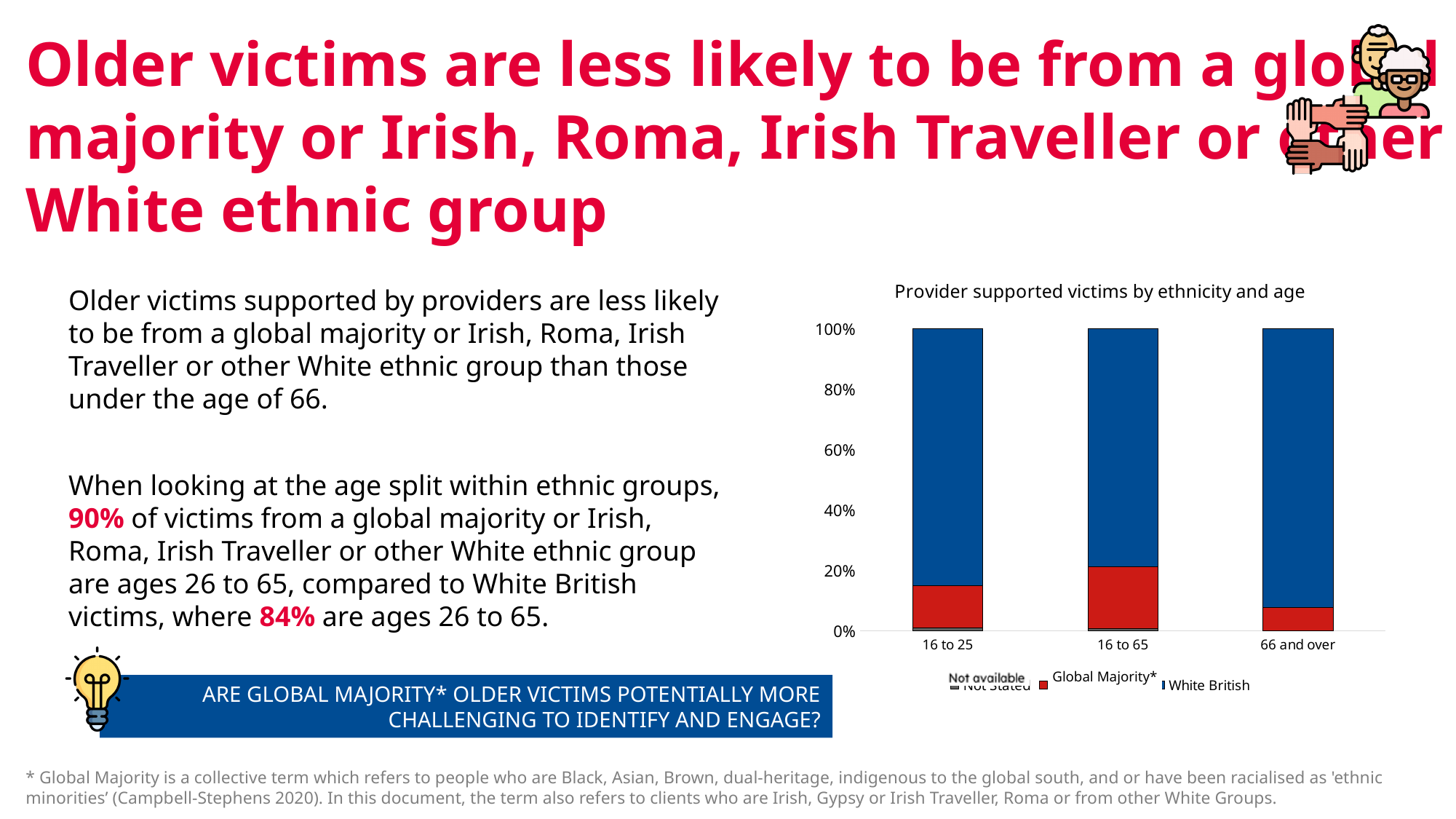
What kind of chart is shown on the slide? Stacked bar chart Which age category has the largest White British share in the chart? 66 and over Is the Global Majority* share for 66 and over greater or less than 20%? less What colour represents the White British series in the chart? Blue Which has the larger Global Majority* share: 16 to 25 or 66 and over? 16 to 25 What is the title of the chart on the slide? Provider supported victims by ethnicity and age Is the Global Majority* share for 16 to 25 greater or less than 20%? less Is the White British share for 66 and over greater or less than 80%? greater Which age category has the smallest Global Majority* share in the chart? 66 and over Which age category has the largest Global Majority* share in the chart? 16 to 65 How many age categories are shown on the x axis of the chart? 3